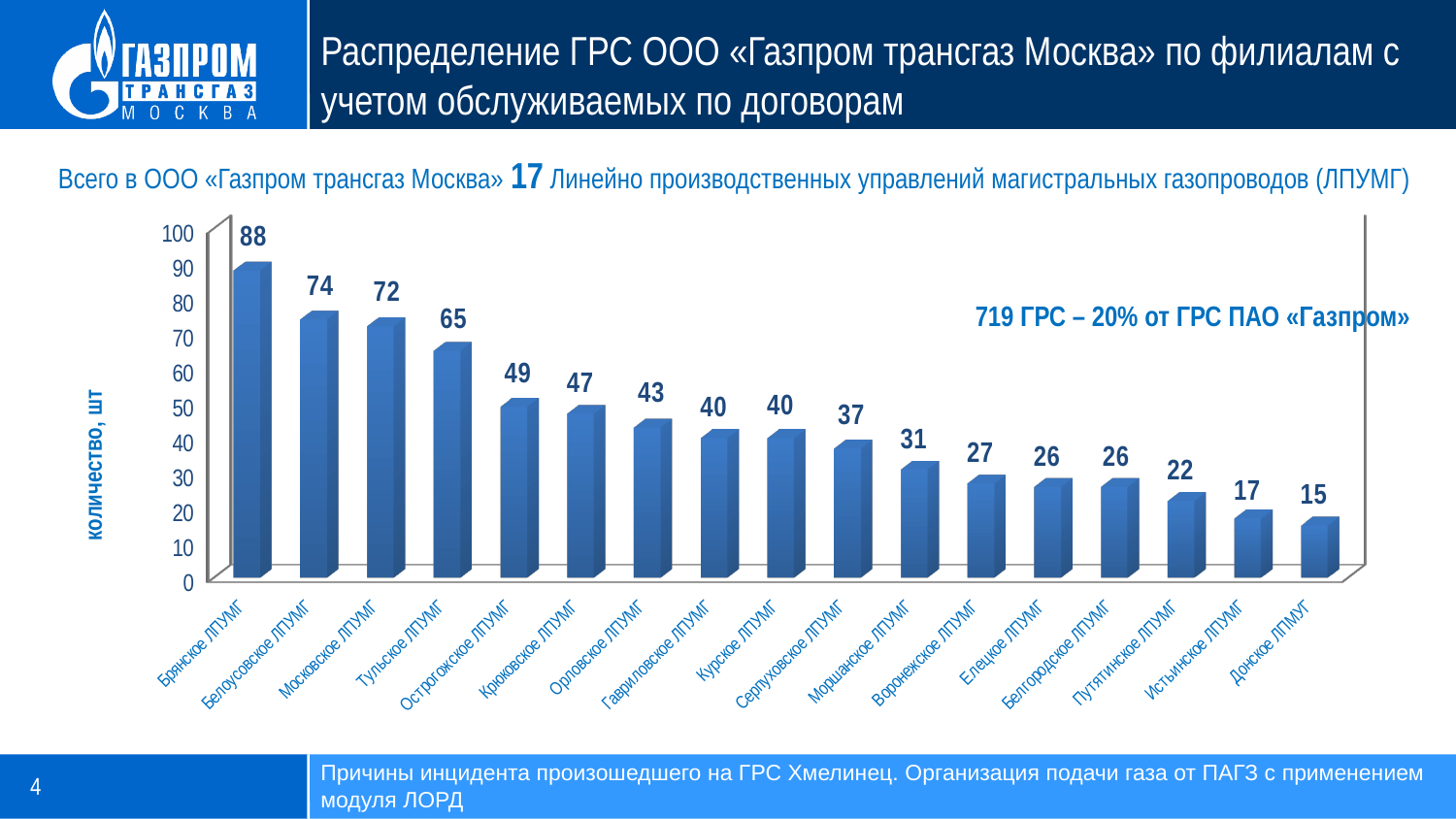
Which is larger, the value for Острогожское ЛПУМГ or Крюковское ЛПУМГ? Острогожское ЛПУМГ Do the values rise or fall from left to right along the x axis? Fall Which category has the lowest value? Донское ЛПМУГ What is the value for Брянское ЛПУМГ? 88 Which category has the highest value? Брянское ЛПУМГ What is the value for Тульское ЛПУМГ? 65 What is the value for Донское ЛПМУГ? 15 What is the difference between the values for Белоусовское ЛПУМГ and Московское ЛПУМГ? 2 How many ЛПУМГ categories are plotted on the chart? 17 What is the label on the vertical axis of the chart? количество, шт What is the value for Серпуховское ЛПУМГ? 37 What type of chart is shown on the slide? Bar chart